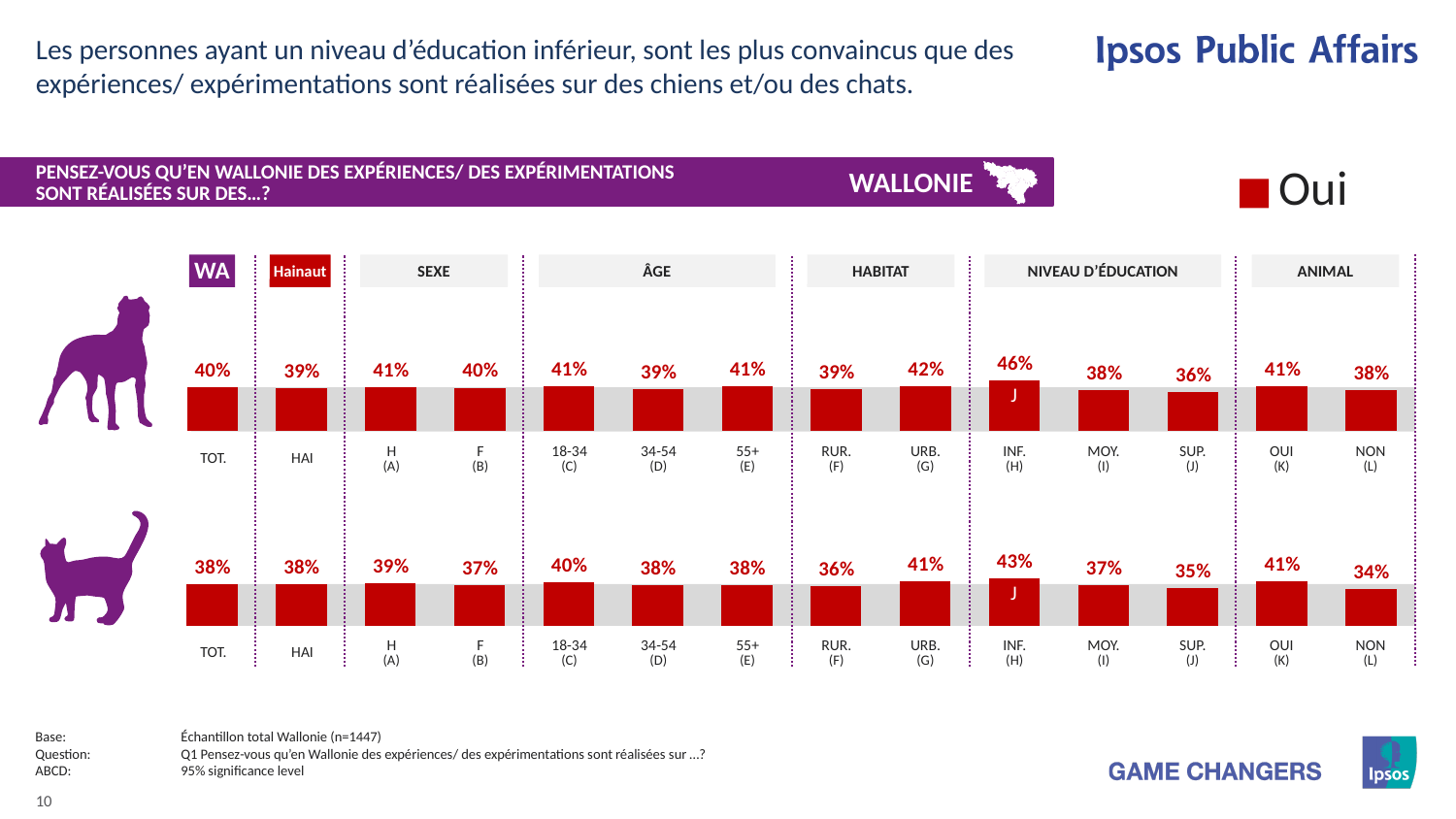
In the top row (dog) chart, what is the difference between INF. (H) and SUP. (J)? 10 percentage points In the top row (dog) chart, which category has the highest value? INF. (H) How many categories (bars) are shown in the top row (dog) chart? 14 In the top row (dog) chart, what is the value for URB. (G)? 42% In the bottom row (cat) chart, what is the value for INF. (H) under Niveau d'éducation? 43% How many series does the legend list? 1 What is the legend entry shown on the slide? Oui In the bottom row (cat) chart, which category has the lowest value? NON (L) What kind of chart is used on this slide? Bar chart In the bottom row (cat) chart, which is larger, RUR. (F) or URB. (G)? URB. (G) In the bottom row (cat) chart, what is the difference between OUI (K) and NON (L)? 7 percentage points In the top row (dog) chart, what is the value for TOT. (WA)? 40%